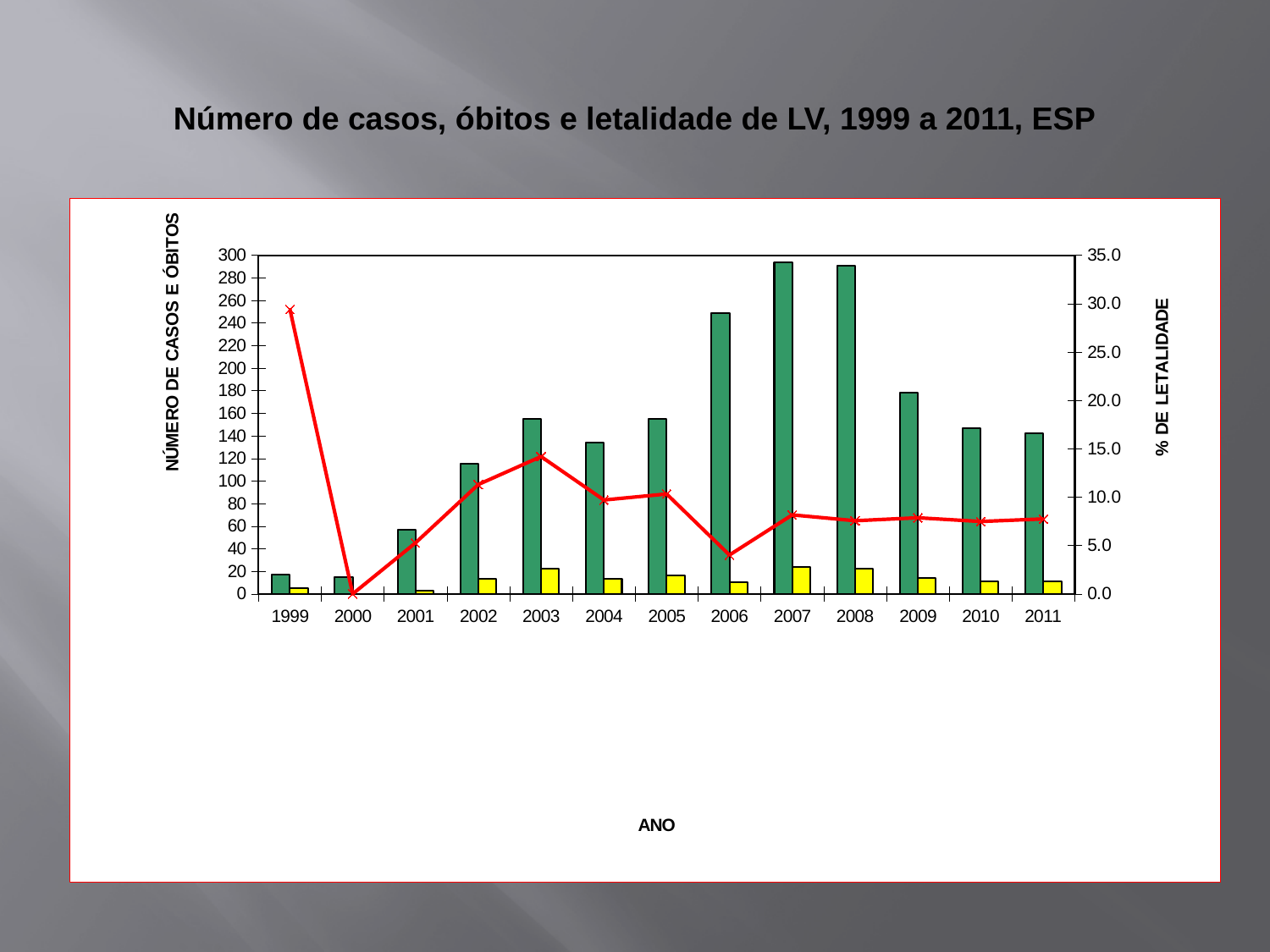
Which year has the taller green bar, 2006 or 2009? 2006 Is the red line value for 1999 greater or less than 25.0? greater What is the title of the chart? Número de casos, óbitos e letalidade de LV, 1999 a 2011, ESP What kind of chart is shown on the slide? A bar chart combined with a line chart In which year does the red line (% de letalidade) reach its lowest value? 2000 Is the green bar for 2001 greater or less than 100? less How many years are shown on the x axis of the chart? 13 Is the green bar for 2006 greater or less than 200? greater Do the green bars rise or fall from 2007 to 2011? fall In which year does the red line (% de letalidade) reach its highest value? 1999 What is the label of the right-hand vertical axis? % DE LETALIDADE What is the value of the red line (% de letalidade) in 2000? 0.0